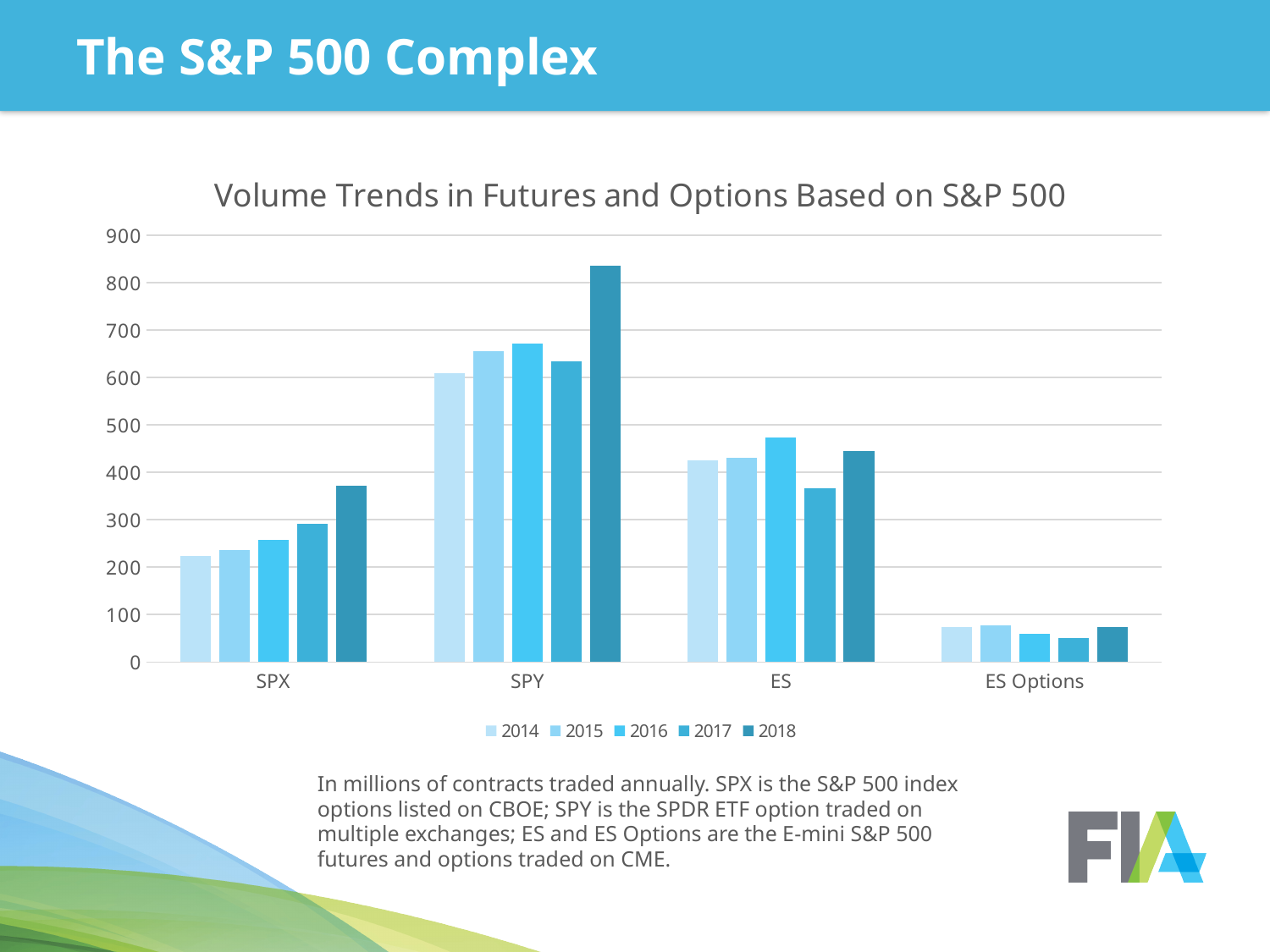
Is the value for SPY in 2018 greater or less than 800? greater Which category has the lowest bars overall? ES Options For SPY, which year has the larger value, 2016 or 2017? 2016 How many categories are shown on the x axis of the chart? 4 What kind of chart is shown on the slide? bar chart How many series does the legend list? 5 Do the SPX values rise or fall from 2014 to 2018? rise Is the value for ES in 2017 greater or less than 400? less Which category has the highest bar for 2018? SPY What is the title of the chart? Volume Trends in Futures and Options Based on S&P 500 Is the value for SPX in 2014 greater or less than 300? less Which years are listed in the chart legend? 2014, 2015, 2016, 2017, 2018